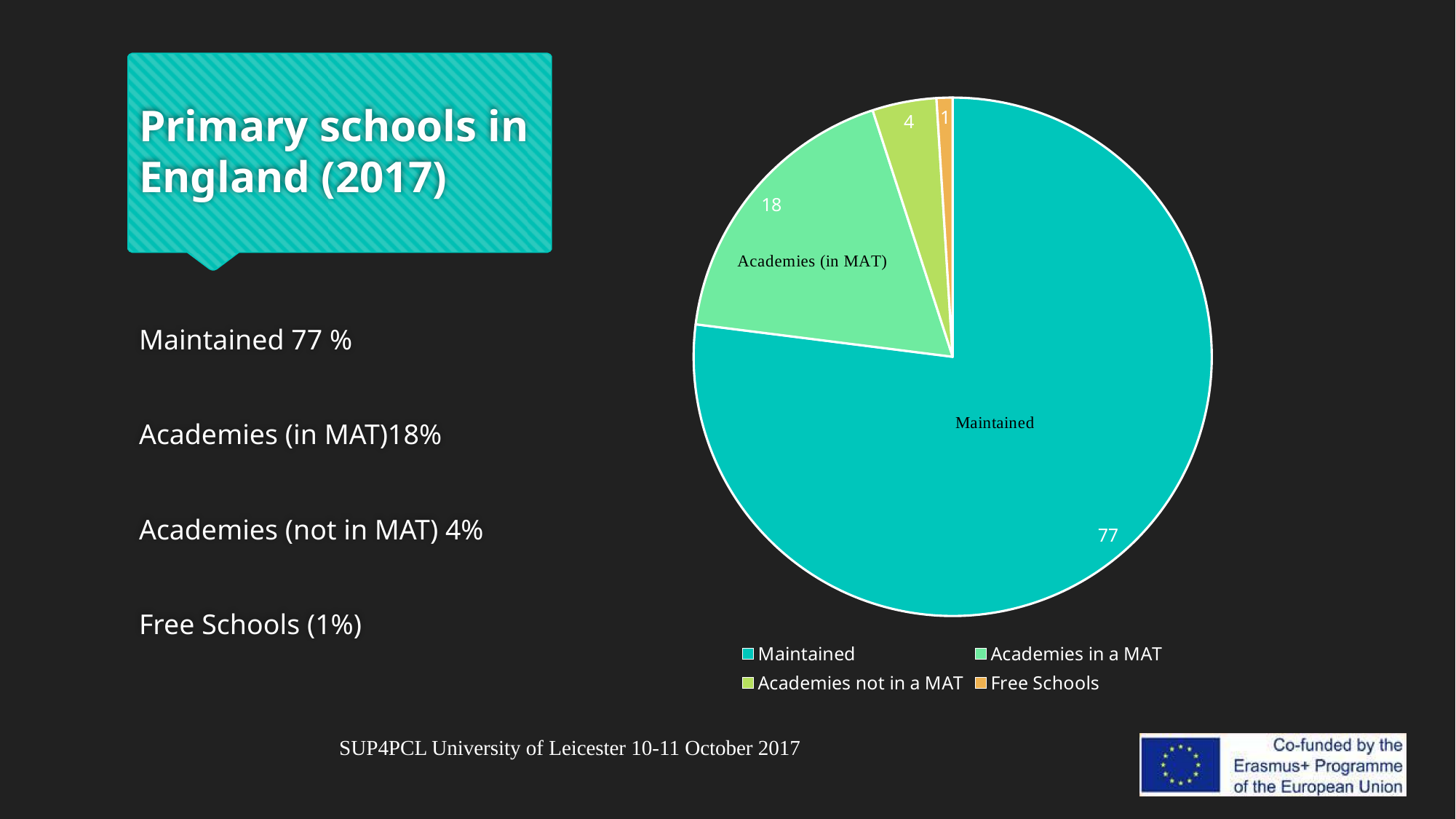
What is the value shown for the Academies not in a MAT slice of the pie chart? 4 What is the value shown for the Maintained slice of the pie chart? 77 How many entries does the legend of the pie chart list? 4 What type of chart is shown on the slide? pie chart What is the value shown for the Free Schools slice of the pie chart? 1 Which category has the largest slice in the pie chart? Maintained Which category has the smallest slice in the pie chart? Free Schools What is the difference between the Maintained value and the Academies in a MAT value in the pie chart? 59 What share of the pie does the Maintained slice represent? 77% What is the value shown for the Academies in a MAT slice of the pie chart? 18 How many slices does the pie chart have? 4 Which is larger in the pie chart: Academies in a MAT or Academies not in a MAT? Academies in a MAT